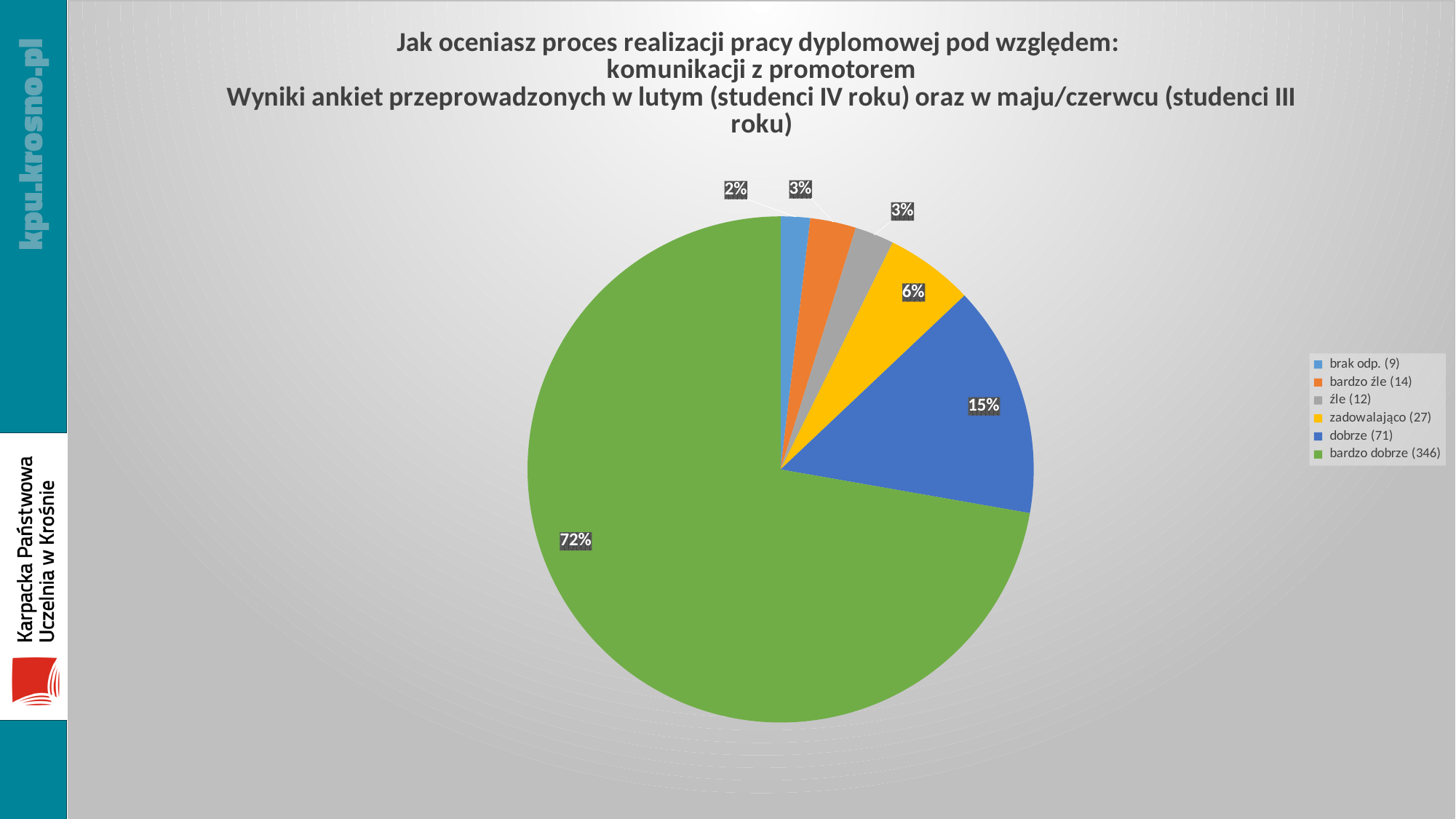
According to the legend, how many responses are in the 'bardzo dobrze' category? 346 What colour is the largest slice of the pie? green What type of chart is shown on the slide? pie chart What percentage is shown for the 'brak odp.' slice? 2% What percentage is shown for the 'zadowalająco' slice? 6% How many slices does the pie chart have? 6 Which slice is larger, 'dobrze' or 'zadowalająco'? dobrze Which category has the smallest share of the pie? brak odp. Which category has the largest share of the pie? bardzo dobrze What is the difference in percentage points between the 'bardzo dobrze' slice and the 'dobrze' slice? 57 What percentage of the pie does the 'bardzo dobrze' slice represent? 72% What percentage is shown for the 'dobrze' slice? 15%